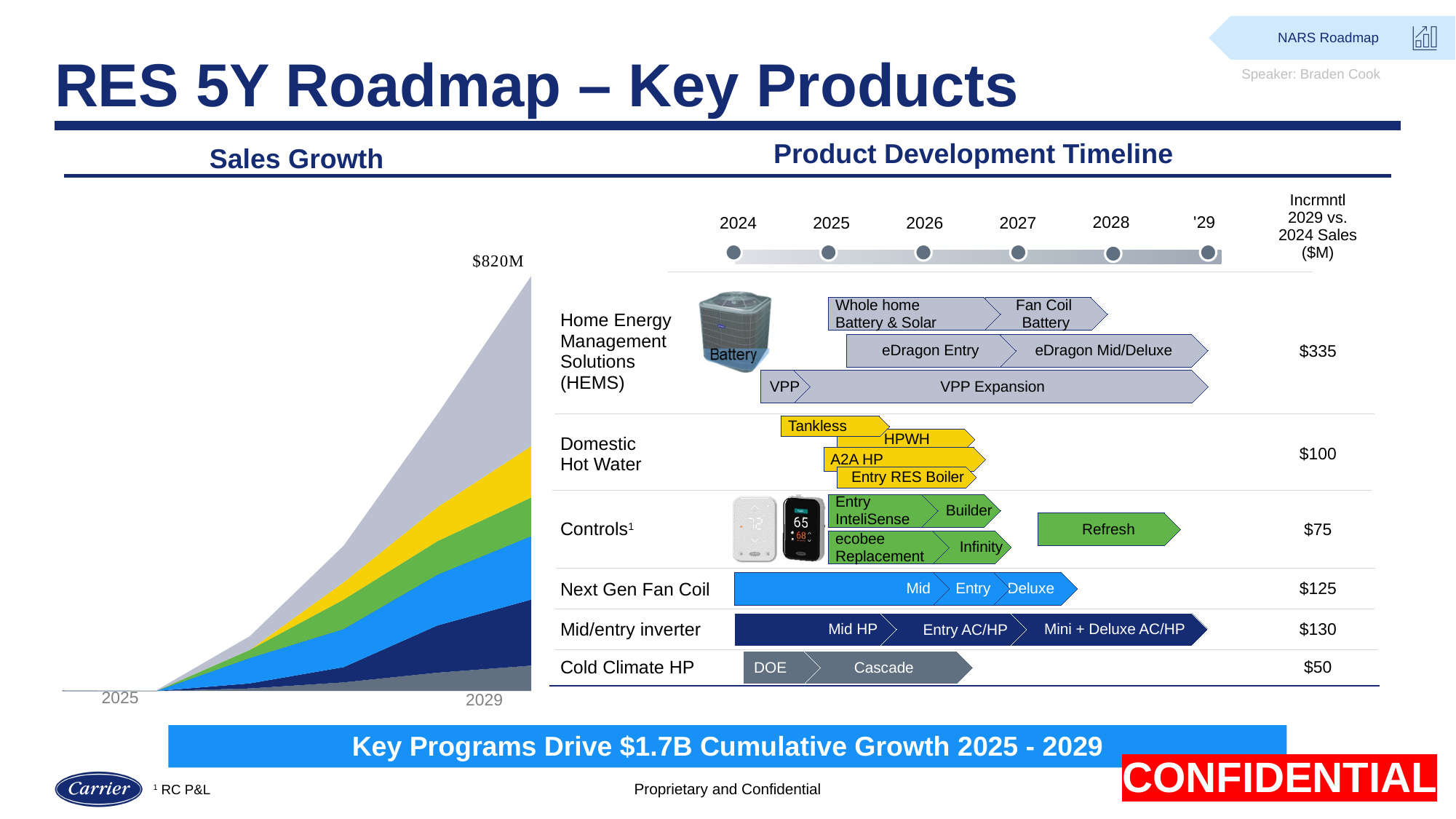
In the Sales Growth chart, how many coloured bands are stacked in the area chart? 6 What kind of chart is the Sales Growth chart? stacked area chart In the Product Development Timeline, which product line has the highest incremental 2029 vs. 2024 sales? Home Energy Management Solutions (HEMS) In the Product Development Timeline, which has larger incremental sales, Domestic Hot Water or Mid/entry inverter? Mid/entry inverter What is the title of the chart on the left of the slide? Sales Growth In the Product Development Timeline, what is the difference in incremental sales between Mid/entry inverter and Controls? $55 In the Product Development Timeline, which product line has the lowest incremental 2029 vs. 2024 sales? Cold Climate HP In the Product Development Timeline, how many product lines are listed? 6 In the Sales Growth chart, what value is labelled at the top of the chart for 2029? $820M In the Sales Growth chart, do the values rise or fall from 2025 to 2029? rise In the Sales Growth chart, what are the first and last years shown on the x axis? 2025 and 2029 In the Product Development Timeline, what is the incremental 2029 vs. 2024 sales value for Next Gen Fan Coil? $125